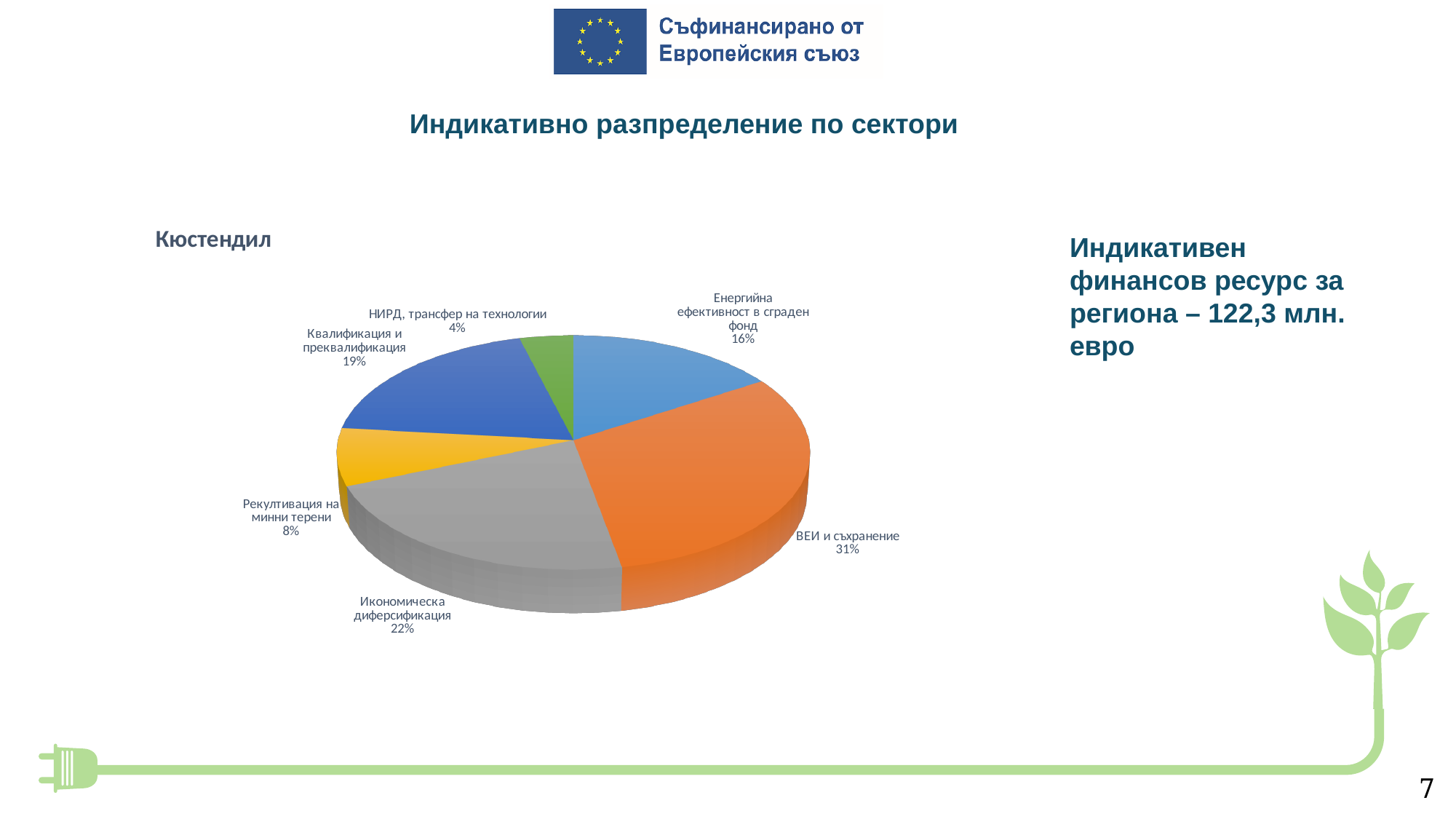
Which sector has the smallest share of the pie? НИРД, трансфер на технологии What share of the pie does ВЕИ и съхранение have? 31% What is the value shown for Енергийна ефективност в сграден фонд? 16% How many sectors are shown in the pie chart? 6 Which is larger: Квалификация и преквалификация or Енергийна ефективност в сграден фонд? Квалификация и преквалификация What is the value shown for Квалификация и преквалификация? 19% What is the title of the chart? Кюстендил What is the value shown for Рекултивация на минни терени? 8% Which sector has the largest share of the pie? ВЕИ и съхранение What is the value shown for Икономическа диверсификация? 22% What is the difference in percentage points between ВЕИ и съхранение and Икономическа диверсификация? 9 What kind of chart is shown on the slide? Pie chart